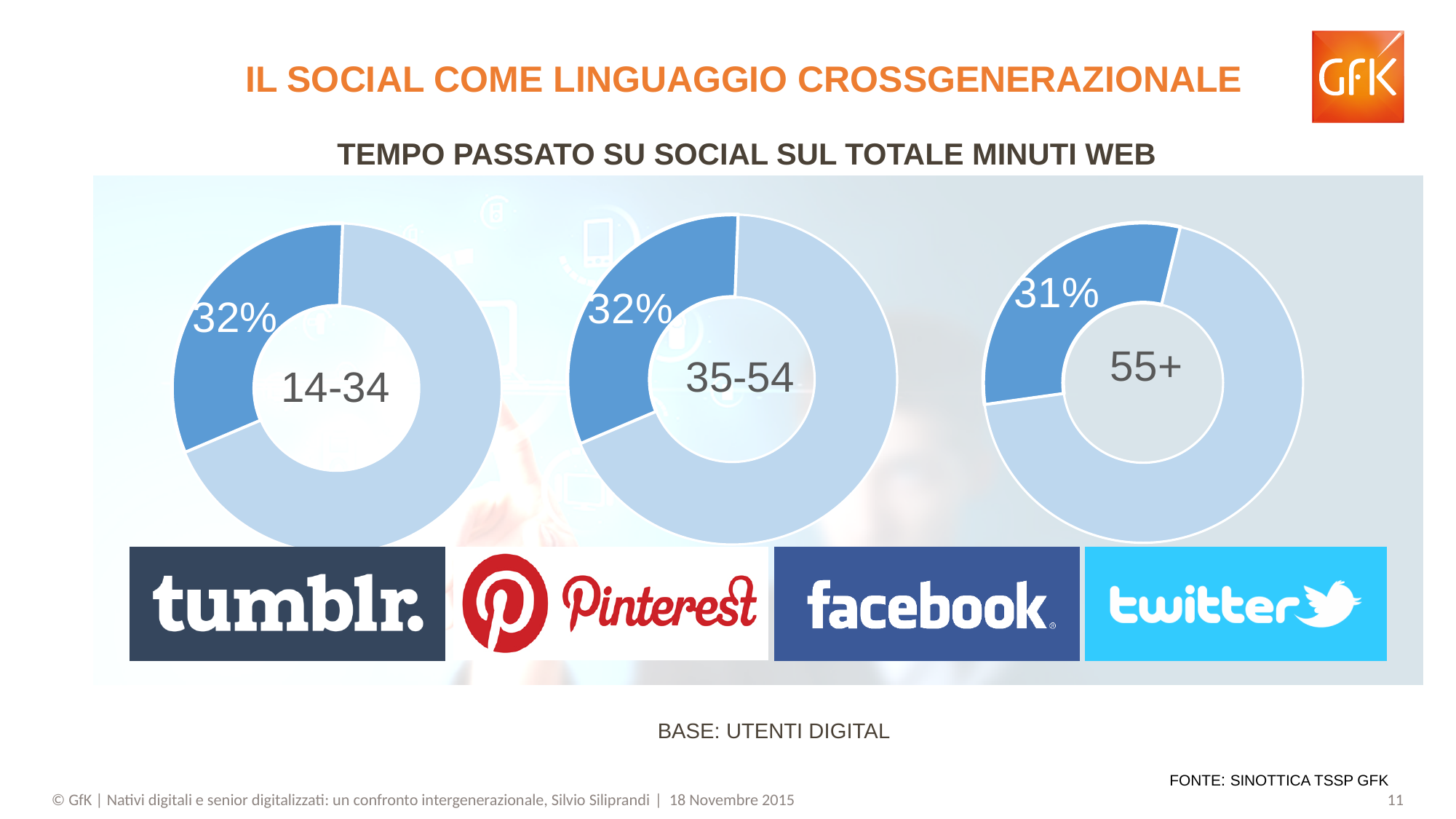
What is the difference between the percentage shown for the 14-34 group and the percentage shown for the 55+ group? 1% What is the title above the donut charts? TEMPO PASSATO SU SOCIAL SUL TOTALE MINUTI WEB How many slices does each donut chart have? 2 Which is larger: the percentage shown for the 35-54 group or the percentage shown for the 55+ group? 35-54 In the donut chart labelled 14-34, what share of total web minutes is spent on social? 32% In the donut chart labelled 35-54, what percentage is shown for time spent on social? 32% In the donut chart labelled 55+, what percentage is shown for time spent on social? 31% How many donut charts are shown on the slide? 3 What kind of chart is used to show the time spent on social for each age group? Donut (pie) chart Which age group's donut chart shows the lowest share of time spent on social? 55+ Do the 14-34 and 35-54 donut charts show the same percentage? Yes, 32% Which age group is labelled in the centre of the middle donut chart? 35-54